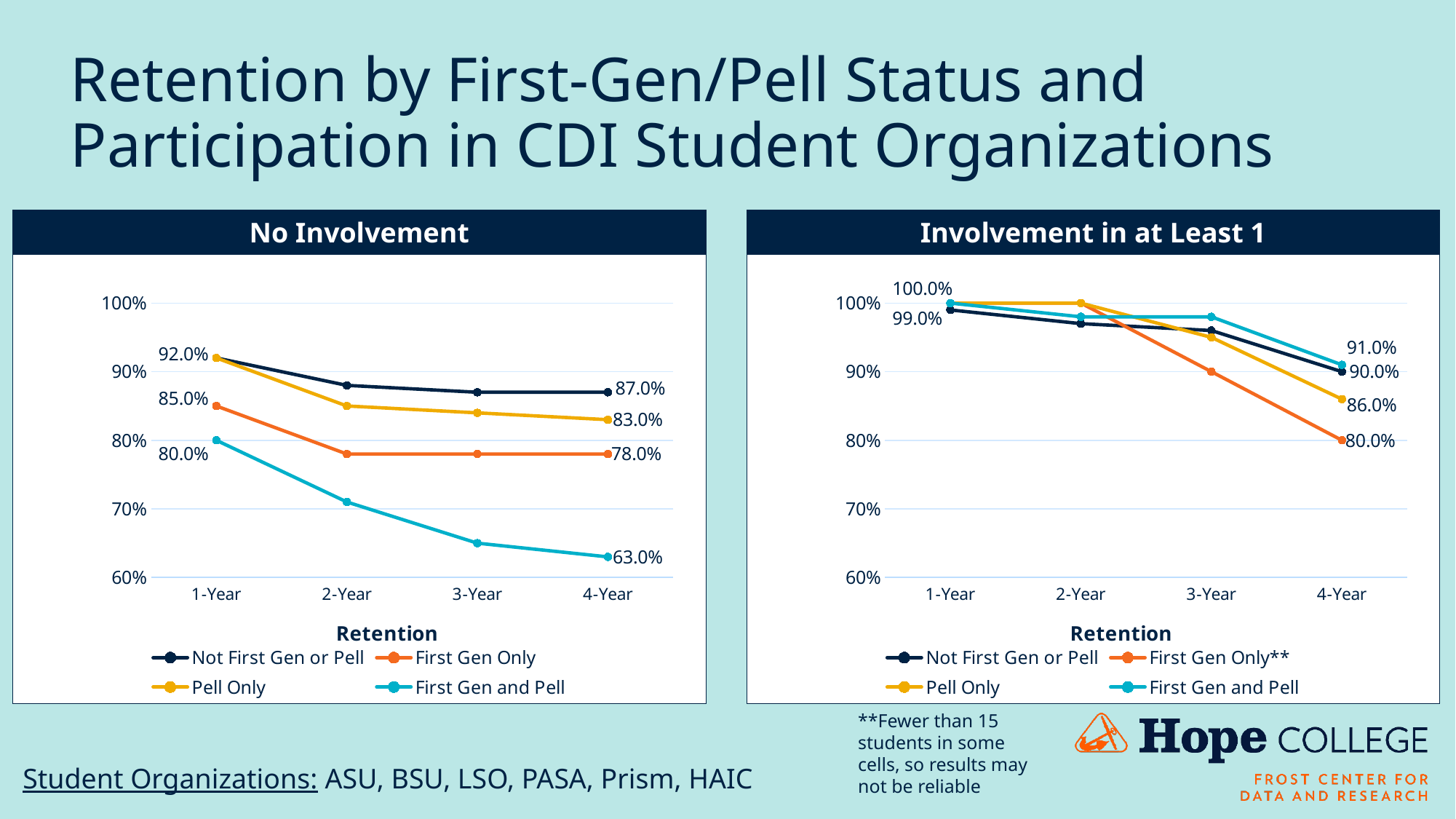
In the No Involvement chart, what is the 1-Year retention value for First Gen Only? 85.0% In the No Involvement chart, what is the 4-Year retention value for First Gen and Pell? 63.0% In the No Involvement chart, which series has the lowest 4-Year retention? First Gen and Pell In the Involvement in at Least 1 chart, which series has the lowest 4-Year retention? First Gen Only What type of chart is the No Involvement chart? Line chart In the No Involvement chart, is the 3-Year value for First Gen and Pell greater or less than 70%? less In the No Involvement chart, which is higher at 4-Year: Not First Gen or Pell or Pell Only? Not First Gen or Pell In the Involvement in at Least 1 chart, what is the difference between the 4-Year values for Not First Gen or Pell and First Gen Only? 10.0 percentage points How many series does the legend of the Involvement in at Least 1 chart list? 4 In the No Involvement chart, by how many percentage points does First Gen and Pell retention drop from 1-Year to 4-Year? 17.0 percentage points In the Involvement in at Least 1 chart, what is the 1-Year retention value for Not First Gen or Pell? 99.0% In the Involvement in at Least 1 chart, what is the 4-Year retention value for First Gen Only? 80.0%